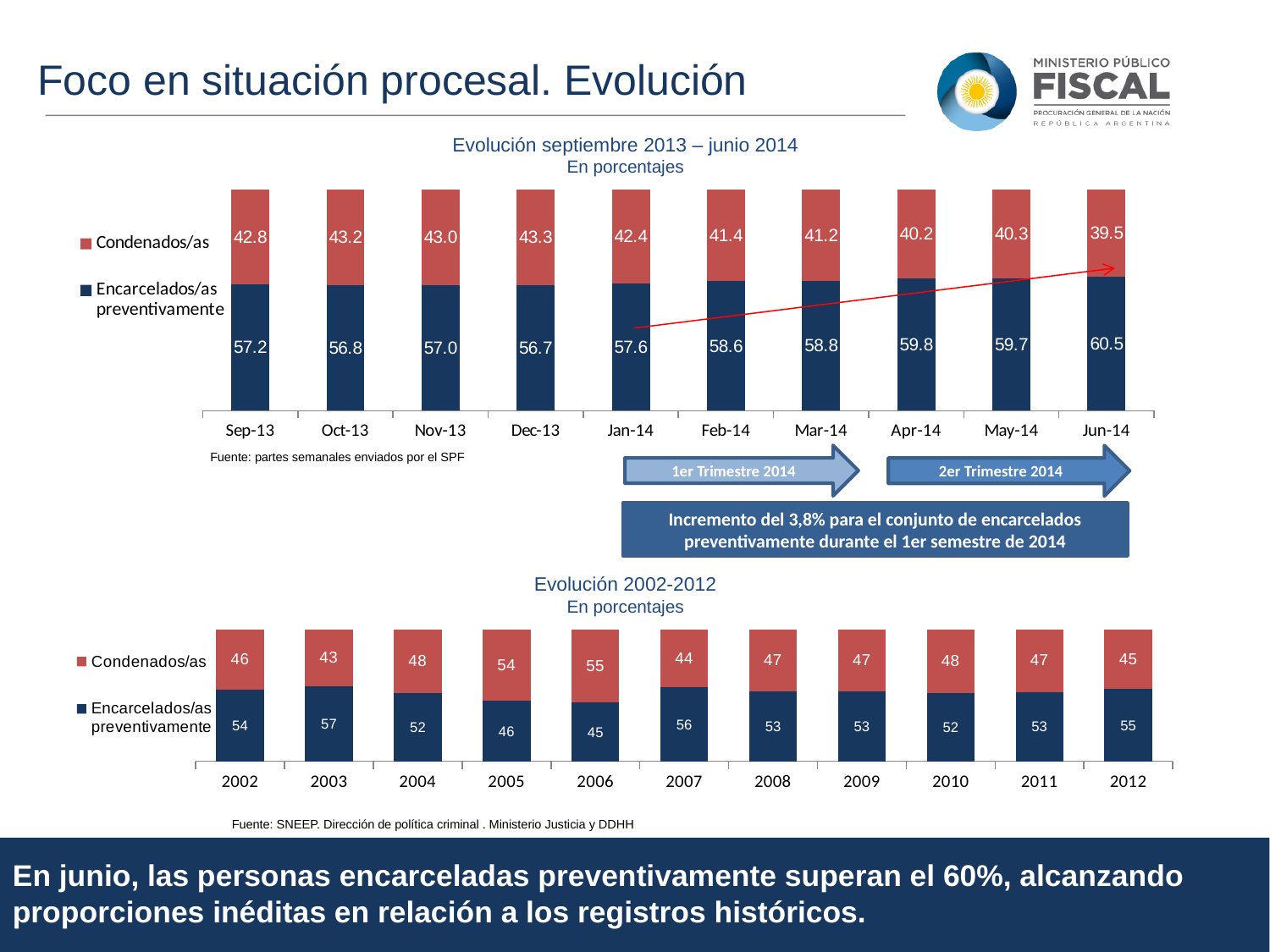
In the chart 'Evolución 2002-2012', which year has the highest value for Condenados/as? 2006 In the chart 'Evolución 2002-2012', how many series does the legend list? 2 In the chart 'Evolución septiembre 2013 – junio 2014', what is the value for Encarcelados/as preventivamente in Jun-14? 60.5 In the chart 'Evolución septiembre 2013 – junio 2014', how many months are shown on the x axis? 10 In the chart 'Evolución 2002-2012', which year has the lowest value for Encarcelados/as preventivamente? 2006 In the chart 'Evolución 2002-2012', which is larger: Encarcelados/as preventivamente in 2007 or in 2010? 2007 In the chart 'Evolución septiembre 2013 – junio 2014', what is the value for Condenados/as in Sep-13? 42.8 In the chart 'Evolución septiembre 2013 – junio 2014', what is the difference between the Encarcelados/as preventivamente values for Jun-14 and Sep-13? 3.3 In the chart 'Evolución 2002-2012', what is the value for Encarcelados/as preventivamente in 2003? 57 In the chart 'Evolución septiembre 2013 – junio 2014', which month has the highest value for Encarcelados/as preventivamente? Jun-14 In the chart 'Evolución septiembre 2013 – junio 2014', does the Encarcelados/as preventivamente series generally rise or fall from Sep-13 to Jun-14? rise In the chart 'Evolución septiembre 2013 – junio 2014', which month has the lowest value for Condenados/as? Jun-14